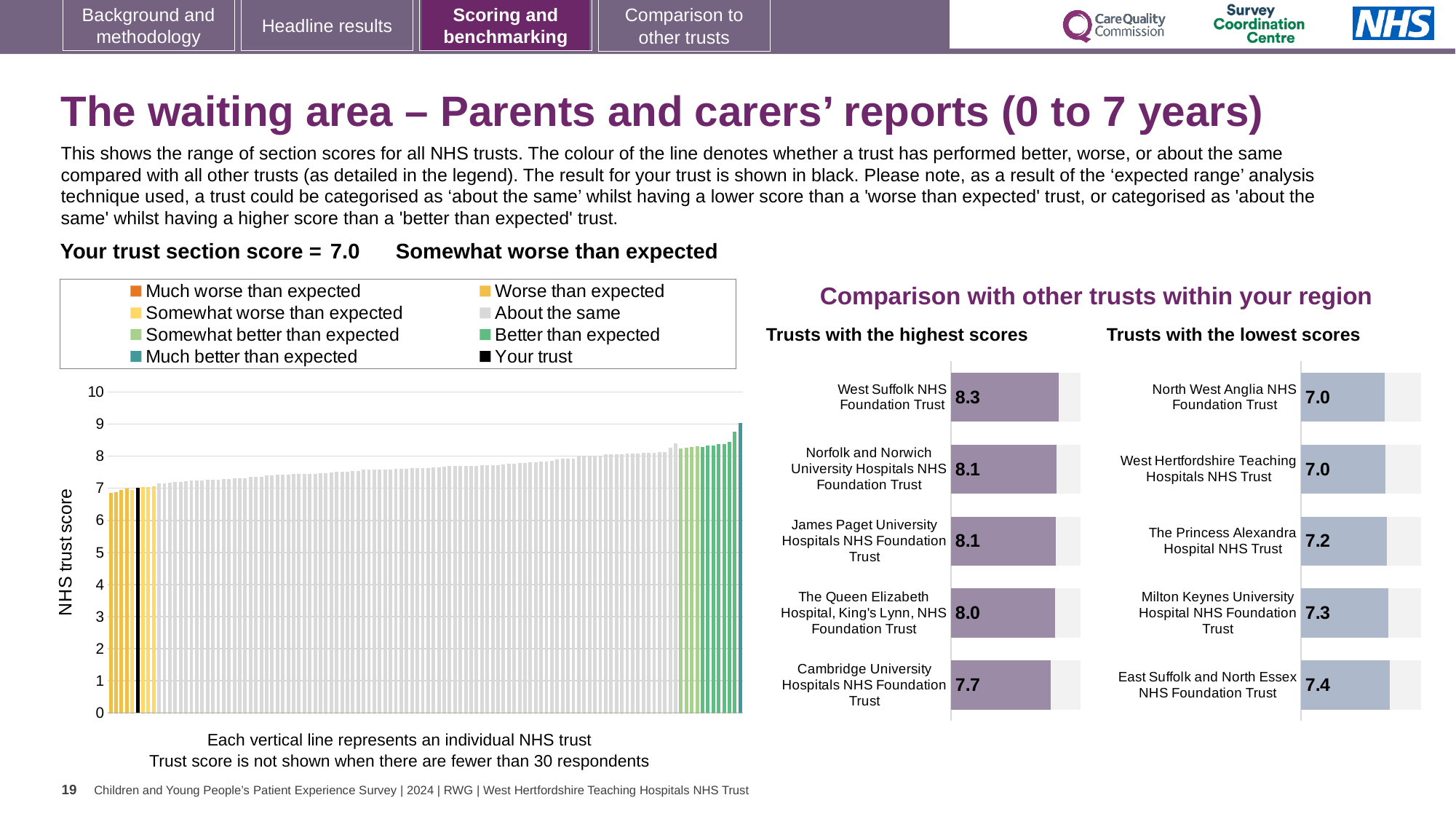
In the 'Trusts with the lowest scores' chart, what is the score for The Princess Alexandra Hospital NHS Trust? 7.2 In the 'Trusts with the highest scores' chart, what is the difference between the scores of West Suffolk NHS Foundation Trust and Cambridge University Hospitals NHS Foundation Trust? 0.6 How many trusts are shown in the 'Trusts with the highest scores' chart? 5 In the 'Trusts with the highest scores' chart, what is the score for Cambridge University Hospitals NHS Foundation Trust? 7.7 In the 'Trusts with the highest scores' chart, which trust has the highest score? West Suffolk NHS Foundation Trust In the 'NHS trust score' chart on the left, do the values rise or fall from left to right? Rise In the 'Trusts with the lowest scores' chart, which has the higher score: Milton Keynes University Hospital NHS Foundation Trust or The Princess Alexandra Hospital NHS Trust? Milton Keynes University Hospital NHS Foundation Trust In the 'Trusts with the lowest scores' chart, which trust has the highest score? East Suffolk and North Essex NHS Foundation Trust In the 'Trusts with the lowest scores' chart, what is the difference between the scores of East Suffolk and North Essex NHS Foundation Trust and North West Anglia NHS Foundation Trust? 0.4 What kind of chart is the 'NHS trust score' chart on the left of the slide? Bar chart In the 'Trusts with the highest scores' chart, what is the score for West Suffolk NHS Foundation Trust? 8.3 In the 'NHS trust score' chart on the left, is the value of the tallest bar greater or less than 8? greater